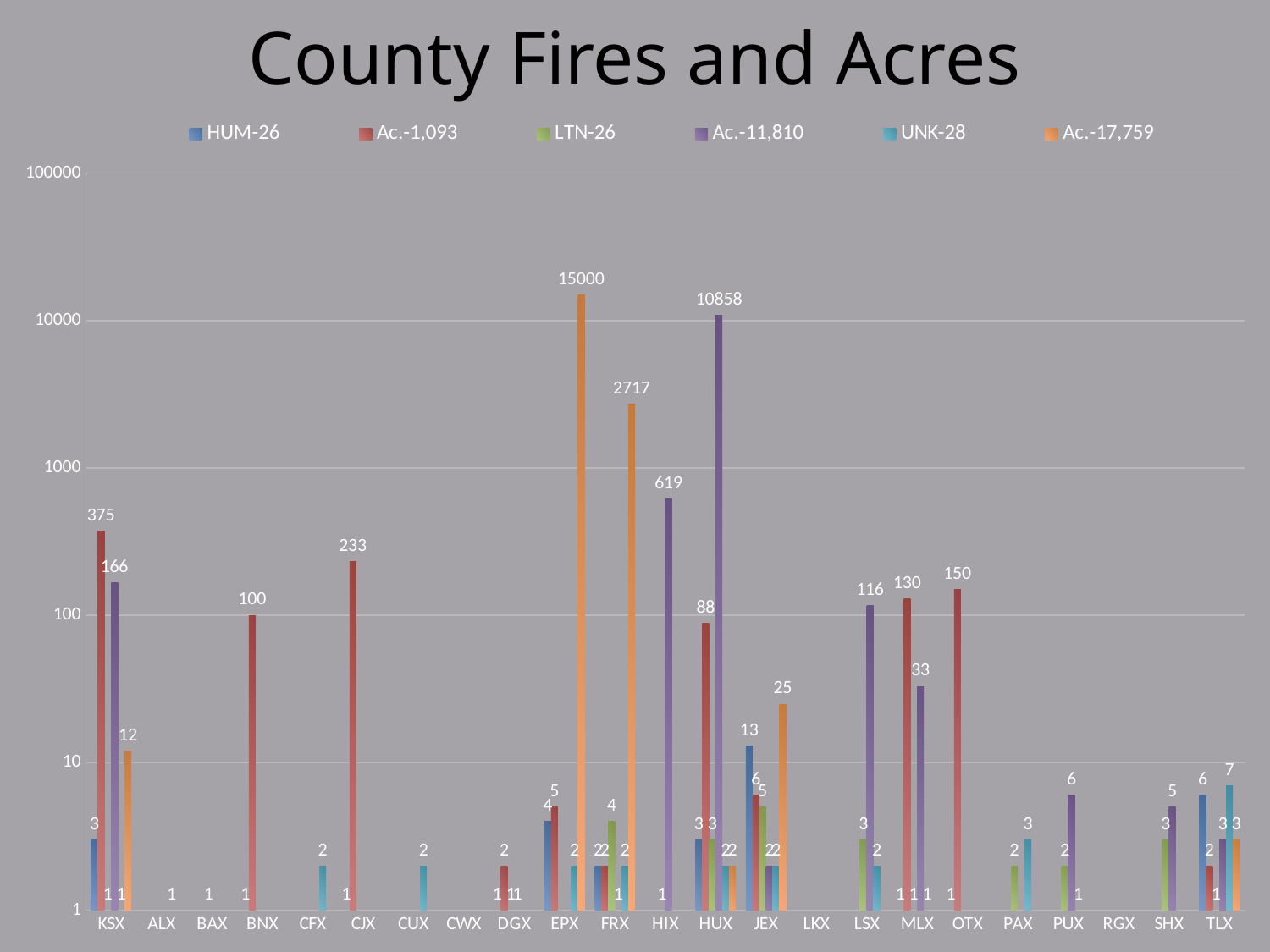
How many county categories are shown along the x axis? 23 Which county has the highest Ac.-11,810 value? HUX What is the HUM-26 value for JEX? 13 What is the title of the chart? County Fires and Acres What is the Ac.-11,810 value for HUX? 10858 How many series does the legend list? 6 What is the difference between the Ac.-17,759 values for EPX and FRX? 12283 What is the Ac.-1,093 value for KSX? 375 Which county has the highest Ac.-17,759 value? EPX What kind of chart is shown on the slide? bar chart Which is larger, the Ac.-1,093 value for CJX or for BNX? CJX What is the Ac.-17,759 value for EPX? 15000